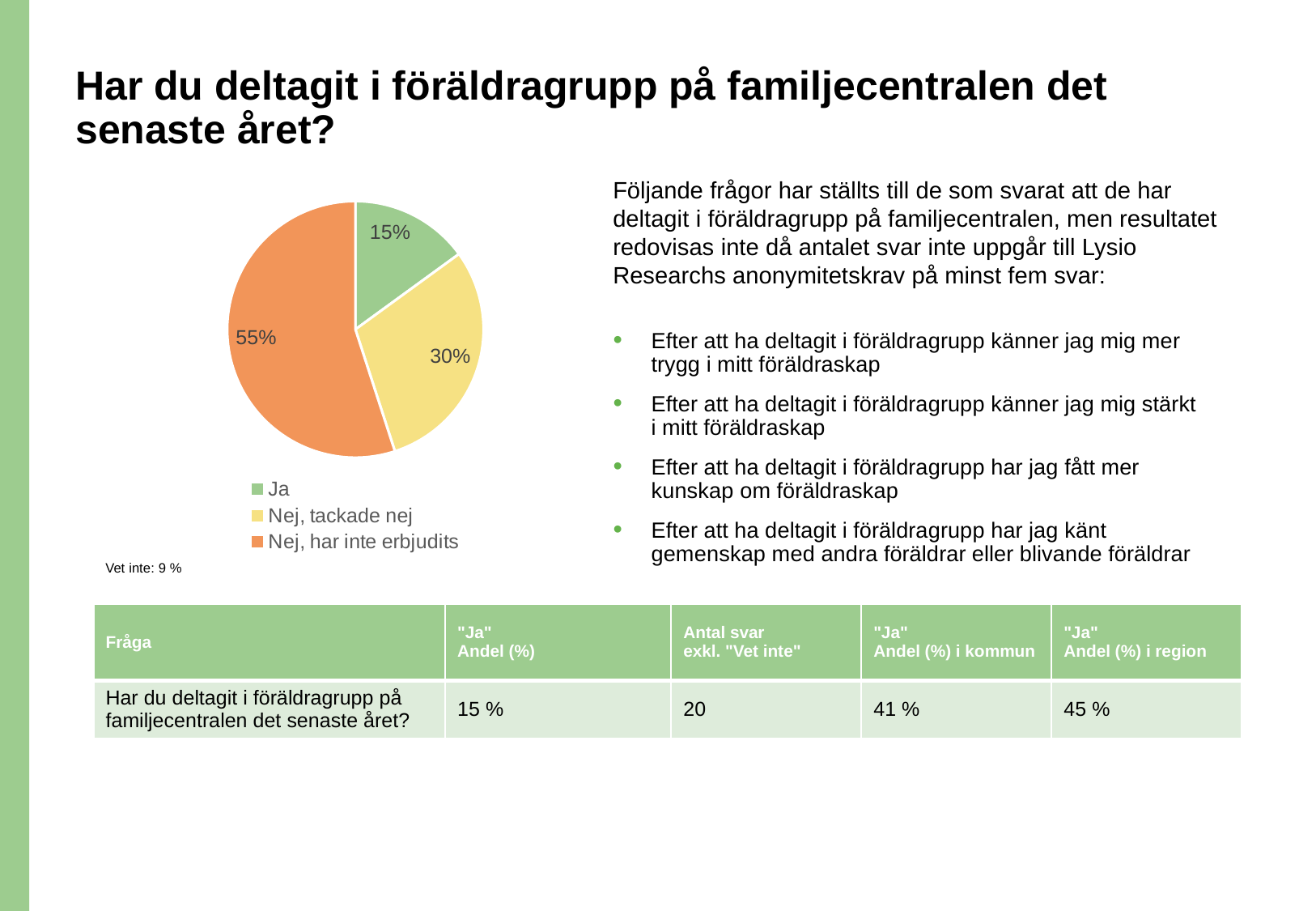
Which category has the largest slice in the pie chart? Nej, har inte erbjudits Which slice is larger in the pie chart: "Ja" or "Nej, tackade nej"? Nej, tackade nej What kind of chart is shown on the slide? pie chart Which category has the smallest slice in the pie chart? Ja What colour is the "Ja" slice in the pie chart? green What share of the pie chart is labelled "Nej, har inte erbjudits"? 55% How many slices does the pie chart have? 3 What is the difference in percentage points between the "Nej, har inte erbjudits" slice and the "Nej, tackade nej" slice? 25 How many entries does the legend of the pie chart list? 3 What share of the pie chart is labelled "Ja"? 15% What colour is the "Nej, har inte erbjudits" slice in the pie chart? orange What share of the pie chart is labelled "Nej, tackade nej"? 30%